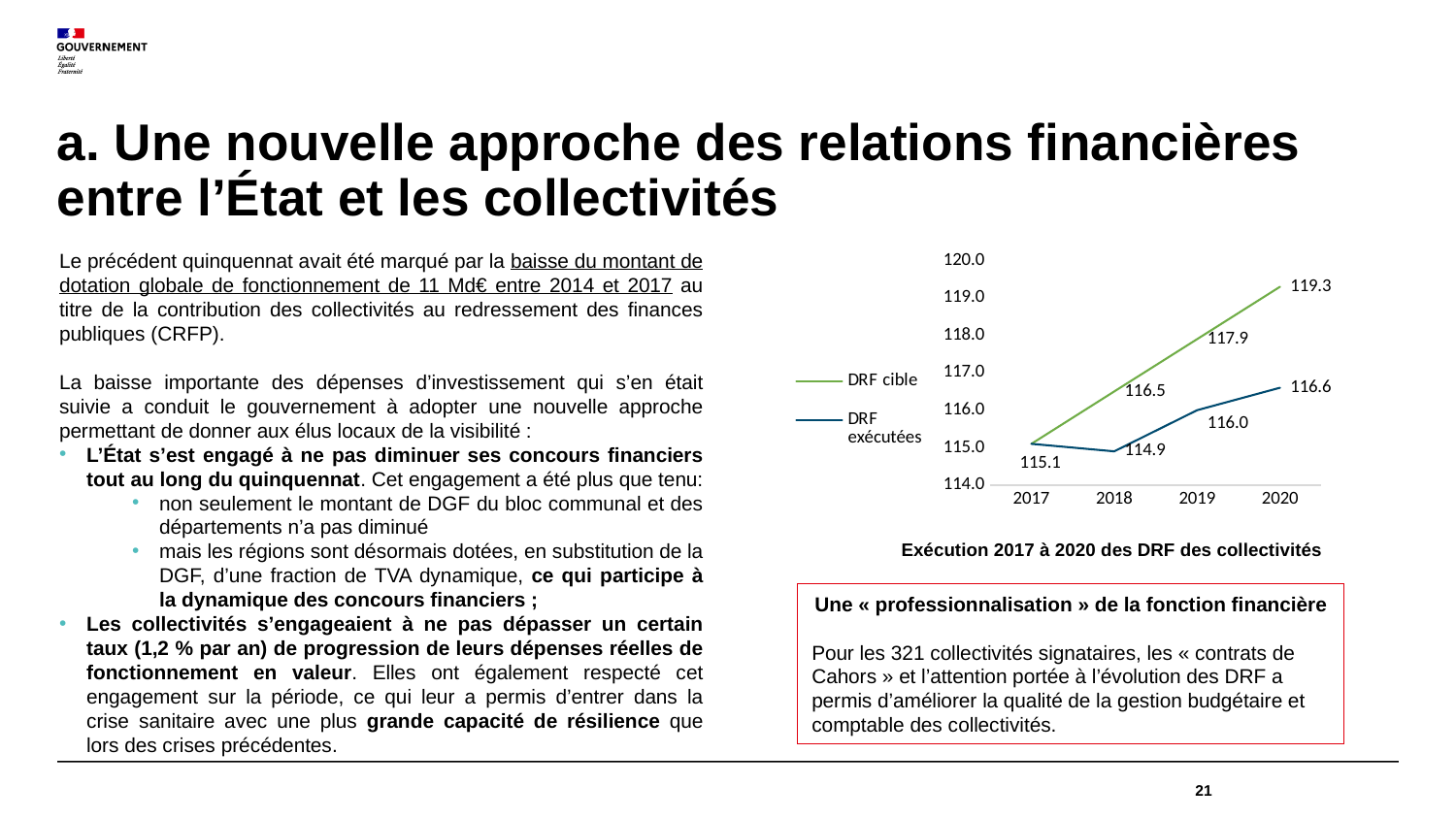
What is the value of DRF exécutées in 2018? 114.9 What is the value of DRF cible in 2018? 116.5 Which series has the higher value in 2019, DRF cible or DRF exécutées? DRF cible What is the difference between DRF cible and DRF exécutées in 2020? 2.7 How many series does the legend list? 2 What kind of chart is shown on the slide? Line chart What is the value of DRF exécutées in 2020? 116.6 What is the value of DRF cible in 2019? 117.9 What is the value of DRF cible in 2020? 119.3 What is the title of the chart? Exécution 2017 à 2020 des DRF des collectivités Does the DRF cible series rise or fall from 2017 to 2020? Rise What value is labelled at 2017 on the chart? 115.1